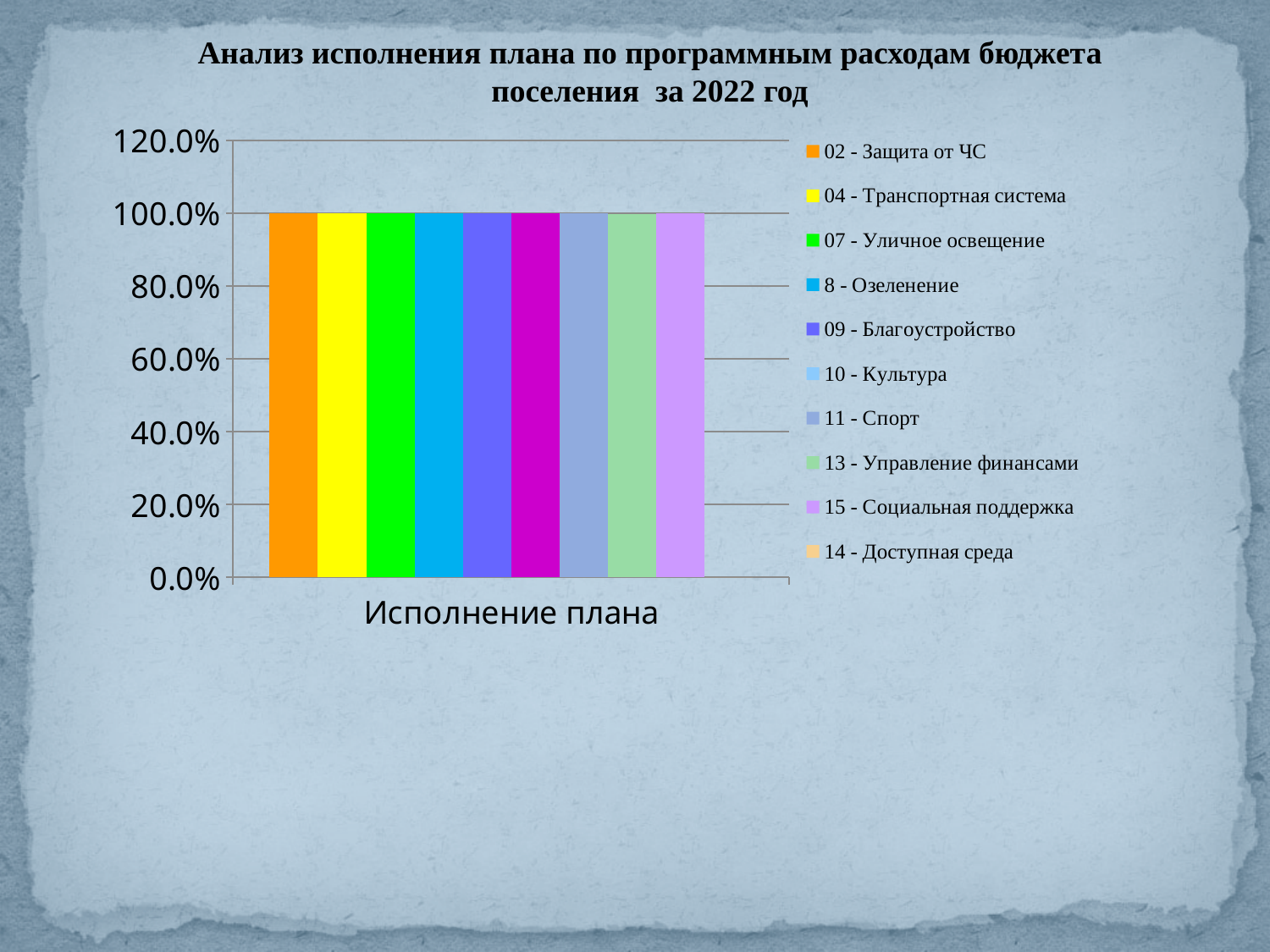
How many series does the legend list? 10 What is the value for 04 - Транспортная система? 100.0% What is the value for 02 - Защита от ЧС? 100.0% What is the category label shown on the x axis? Исполнение плана What is the value for 07 - Уличное освещение? 100.0% What kind of chart is shown on the slide? bar chart What is the title of the chart? Анализ исполнения плана по программным расходам бюджета поселения за 2022 год Is the value for 09 - Благоустройство greater or less than 60.0%? greater Is the value for 15 - Социальная поддержка greater or less than 120.0%? less How many categories are shown on the x axis? 1 Is the value for 02 - Защита от ЧС greater or less than 80.0%? greater